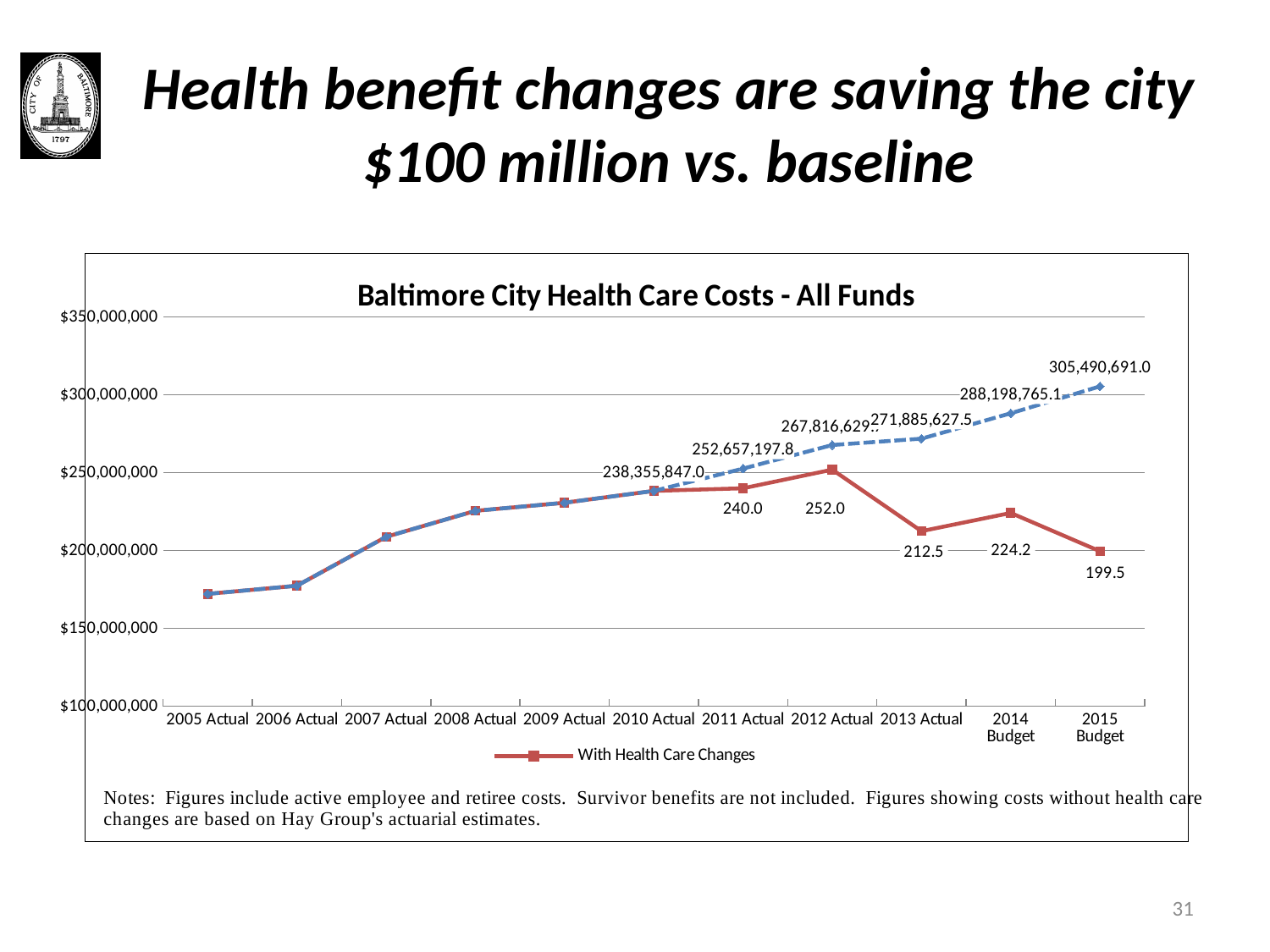
How many categories are shown along the x axis of the chart? 11 What kind of chart is shown on the slide? Line chart How many series does the chart's legend list? 1 What is the difference between the With Health Care Changes labels at 2012 Actual and 2013 Actual? 39.5 What is the data label on the dashed line at 2015 Budget? 305,490,691.0 What is the data label for the With Health Care Changes series at 2015 Budget? 199.5 What is the data label on the dashed line at 2014 Budget? 288,198,765.1 What is the title of the chart? Baltimore City Health Care Costs - All Funds Does the dashed line rise or fall from 2010 Actual to 2015 Budget? Rise Which category has the lowest value for the With Health Care Changes series? 2005 Actual What is the data label for the With Health Care Changes series at 2013 Actual? 212.5 Is the value for 2005 Actual greater or less than $200,000,000? less